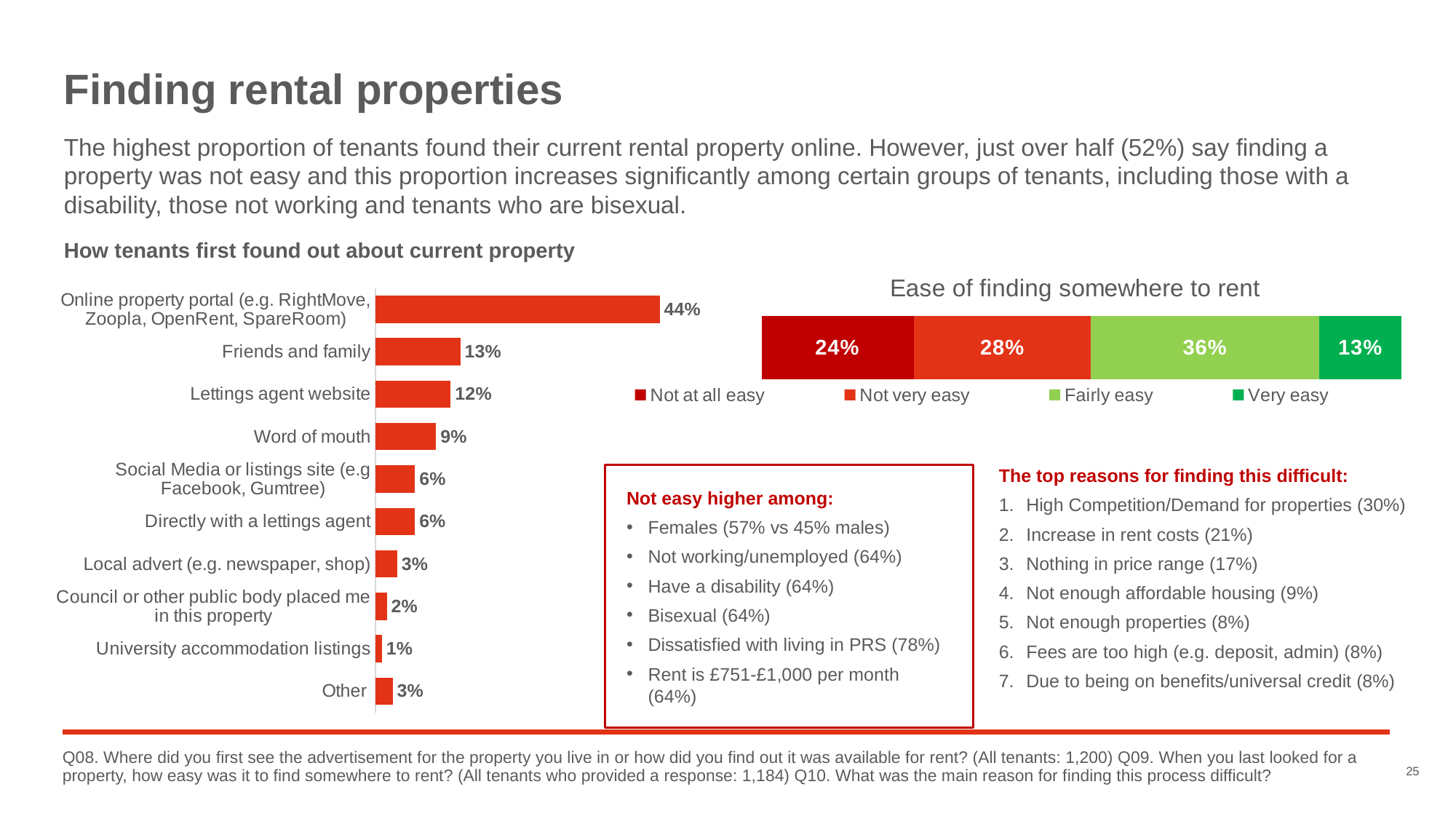
In the 'How tenants first found out about current property' chart, what is the value for Word of mouth? 9% In the 'How tenants first found out about current property' chart, which is larger: Word of mouth or Local advert (e.g. newspaper, shop)? Word of mouth How many categories are shown in the 'How tenants first found out about current property' chart? 10 What type of chart is 'How tenants first found out about current property'? Bar chart How many series does the legend of the 'Ease of finding somewhere to rent' chart list? 4 In the 'Ease of finding somewhere to rent' chart, what is the combined share of Not at all easy and Not very easy? 52% In the 'How tenants first found out about current property' chart, which category has the lowest value? University accommodation listings In the 'Ease of finding somewhere to rent' chart, what percentage said Fairly easy? 36% In the 'How tenants first found out about current property' chart, which category has the highest value? Online property portal (e.g. RightMove, Zoopla, OpenRent, SpareRoom) In the 'How tenants first found out about current property' chart, what is the difference between Friends and family and Lettings agent website? 1% In the 'How tenants first found out about current property' chart, what percentage of tenants found their property through an online property portal? 44% In the 'Ease of finding somewhere to rent' chart, what percentage said Not at all easy? 24%